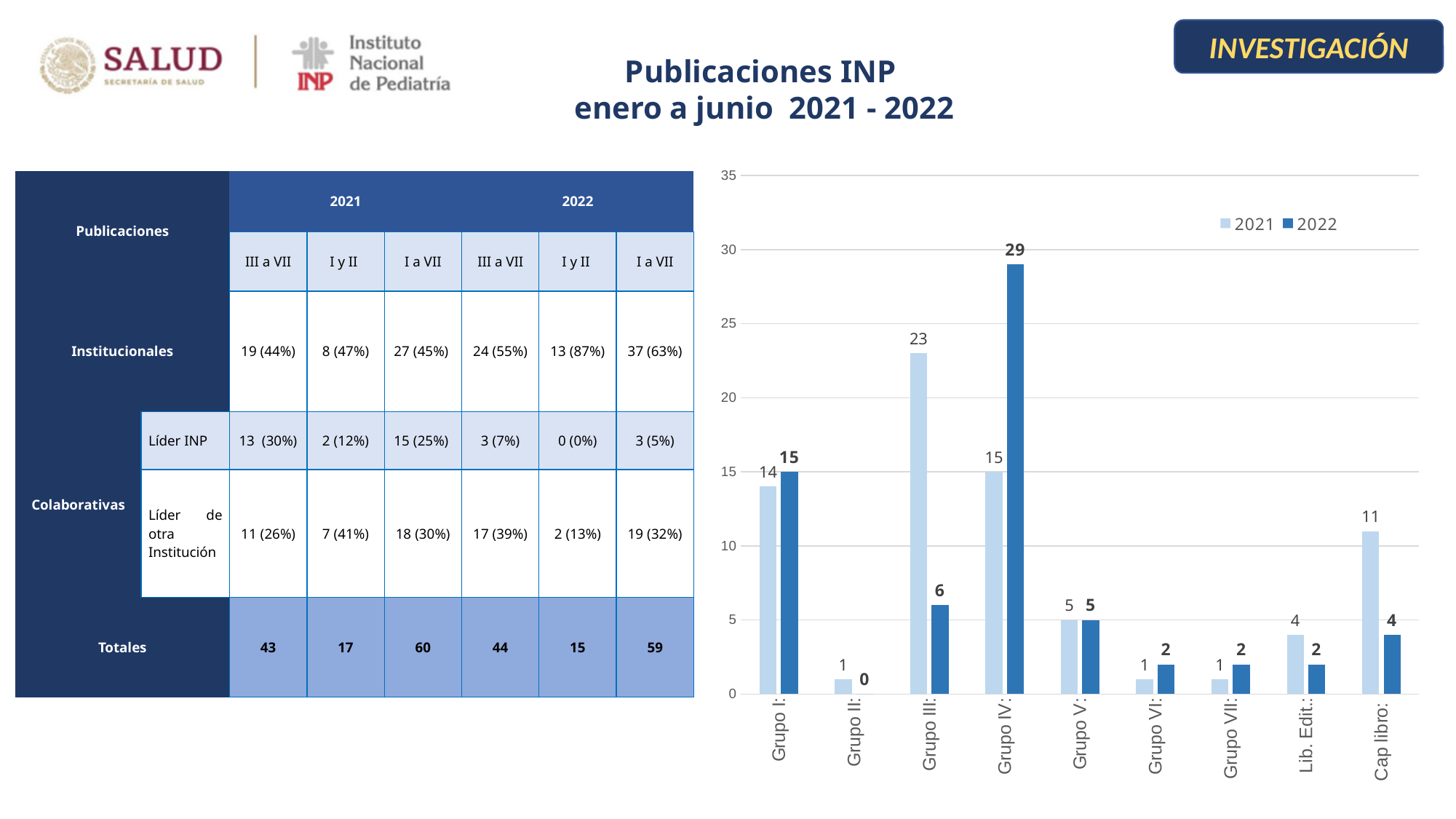
What is the 2022 value for Grupo IV in the bar chart? 29 What is the 2021 value for Cap libro in the bar chart? 11 What is the difference between the 2021 and 2022 values for Grupo III? 17 What kind of chart is shown on the slide? Bar chart Which series is shown in the darker blue colour in the chart? 2022 What is the 2022 value for Grupo II in the bar chart? 0 Which category has the highest 2022 value in the bar chart? Grupo IV Which category has the highest 2021 value in the bar chart? Grupo III Which is larger for Grupo IV: the 2021 value or the 2022 value? 2022 How many categories are shown on the x axis of the bar chart? 9 What is the 2021 value for Grupo III in the bar chart? 23 How many series does the chart legend list? 2